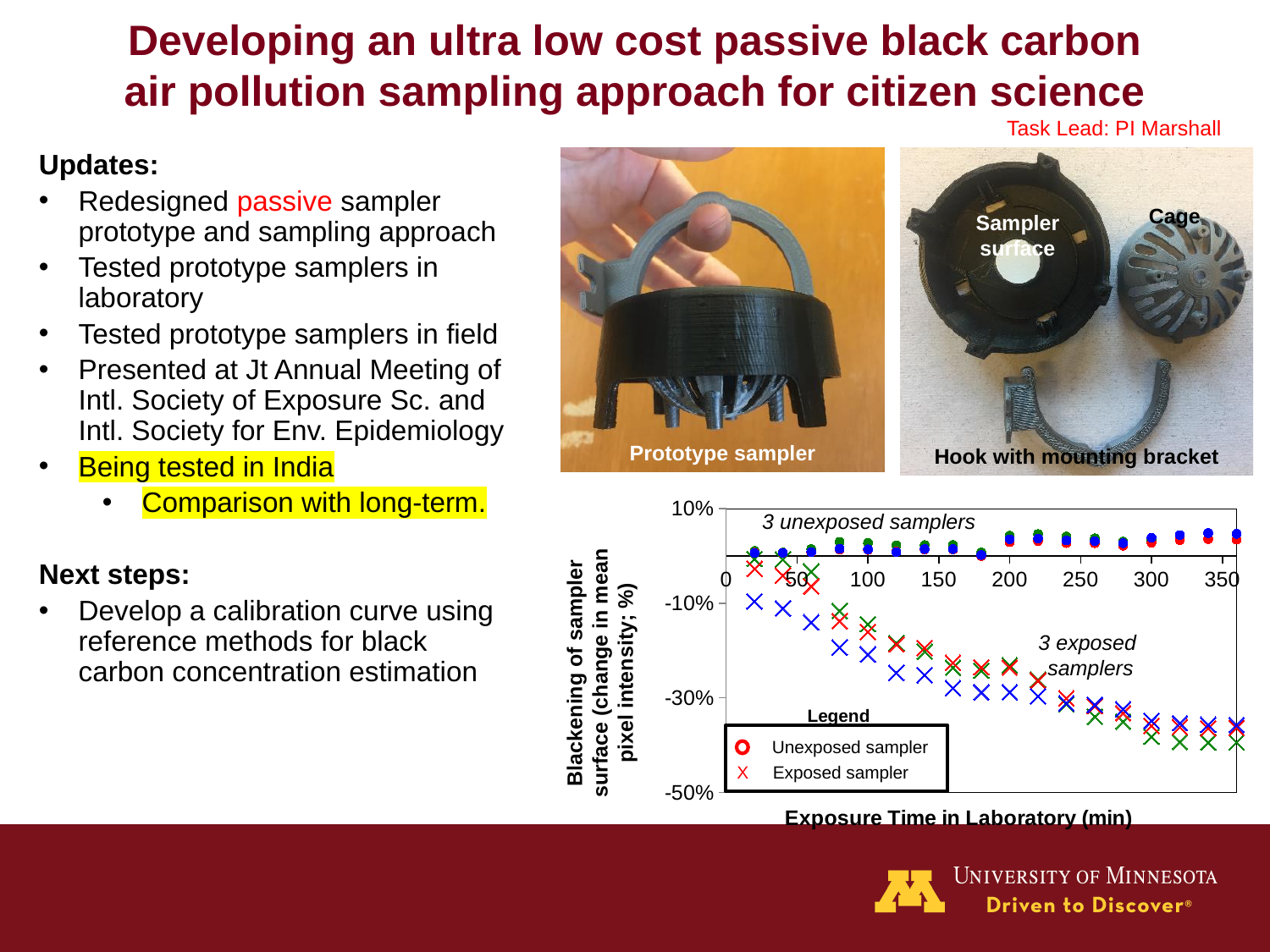
Is the blackening value for the exposed samplers at 350 min greater or less than -30%? less Is the blackening value for the unexposed samplers at 350 min greater or less than -10%? greater Is the blackening value for the exposed samplers at 100 min greater or less than -10%? less How many unexposed samplers are plotted on the chart, according to the annotation? 3 Do the values for the exposed samplers rise or fall as exposure time increases? fall What are the two entries in the chart legend? Unexposed sampler, Exposed sampler At 300 min, which series has the larger blackening value, the unexposed samplers or the exposed samplers? Unexposed samplers How many series does the chart legend list? 2 How many exposed samplers are plotted on the chart, according to the annotation? 3 What is the x-axis title of the chart? Exposure Time in Laboratory (min) What kind of chart is shown on the slide? scatter plot